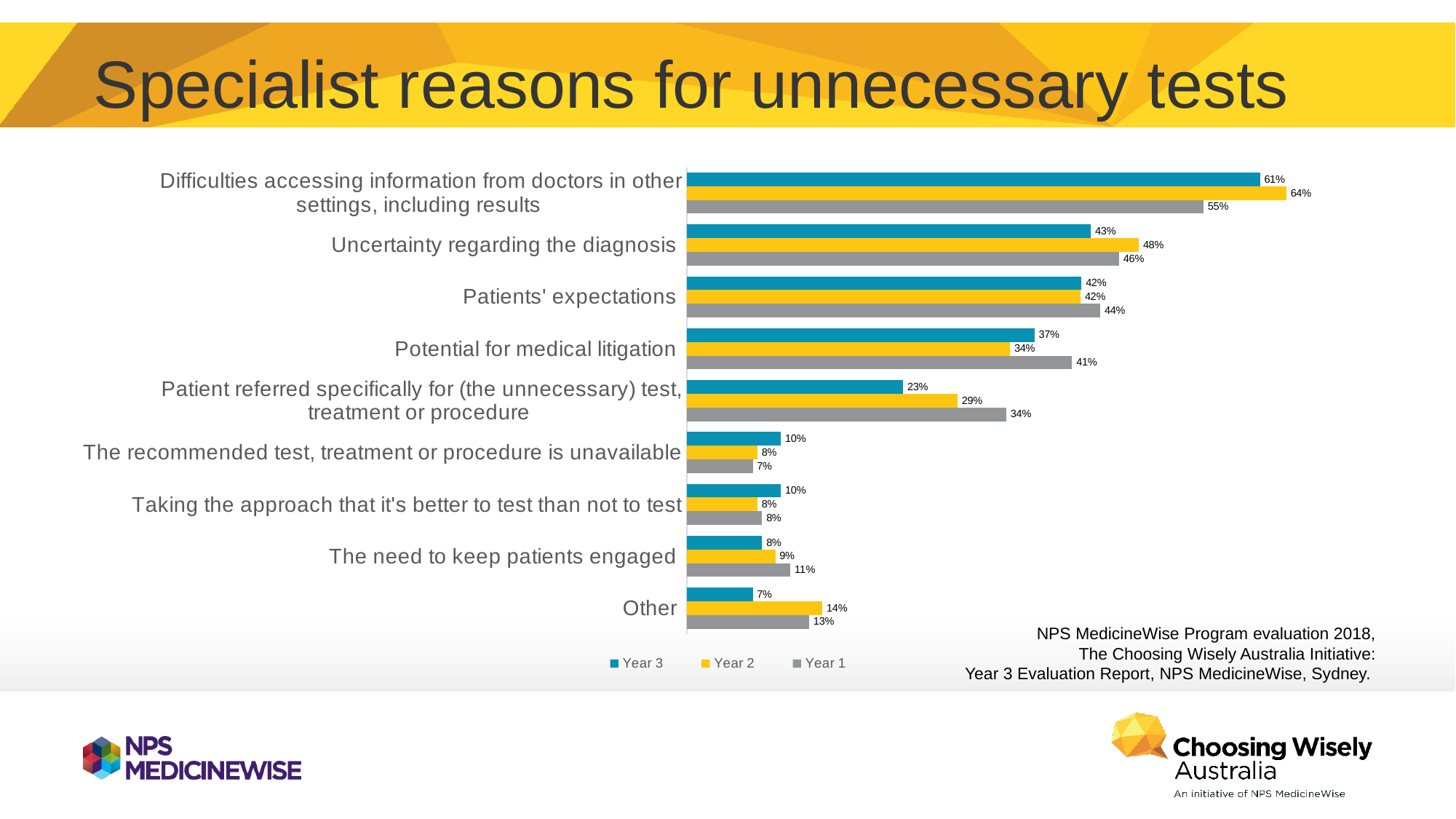
Which category has the lowest Year 3 value? Other What kind of chart is shown on the slide? Bar chart What is the difference between the Year 1 and Year 3 values for "Patient referred specifically for (the unnecessary) test, treatment or procedure"? 11% For "Other", which is larger: the Year 2 value or the Year 3 value? Year 2 Which colour represents Year 1 in the chart? Grey What is the difference between the Year 2 and Year 1 values for "Difficulties accessing information from doctors in other settings, including results"? 9% How many reason categories are shown on the chart? 9 Which category has the highest Year 2 value? Difficulties accessing information from doctors in other settings, including results How many series does the legend list? 3 What is the Year 2 value for "Uncertainty regarding the diagnosis"? 48% What is the Year 1 value for "Potential for medical litigation"? 41% What is the Year 3 value for "Patient referred specifically for (the unnecessary) test, treatment or procedure"? 23%